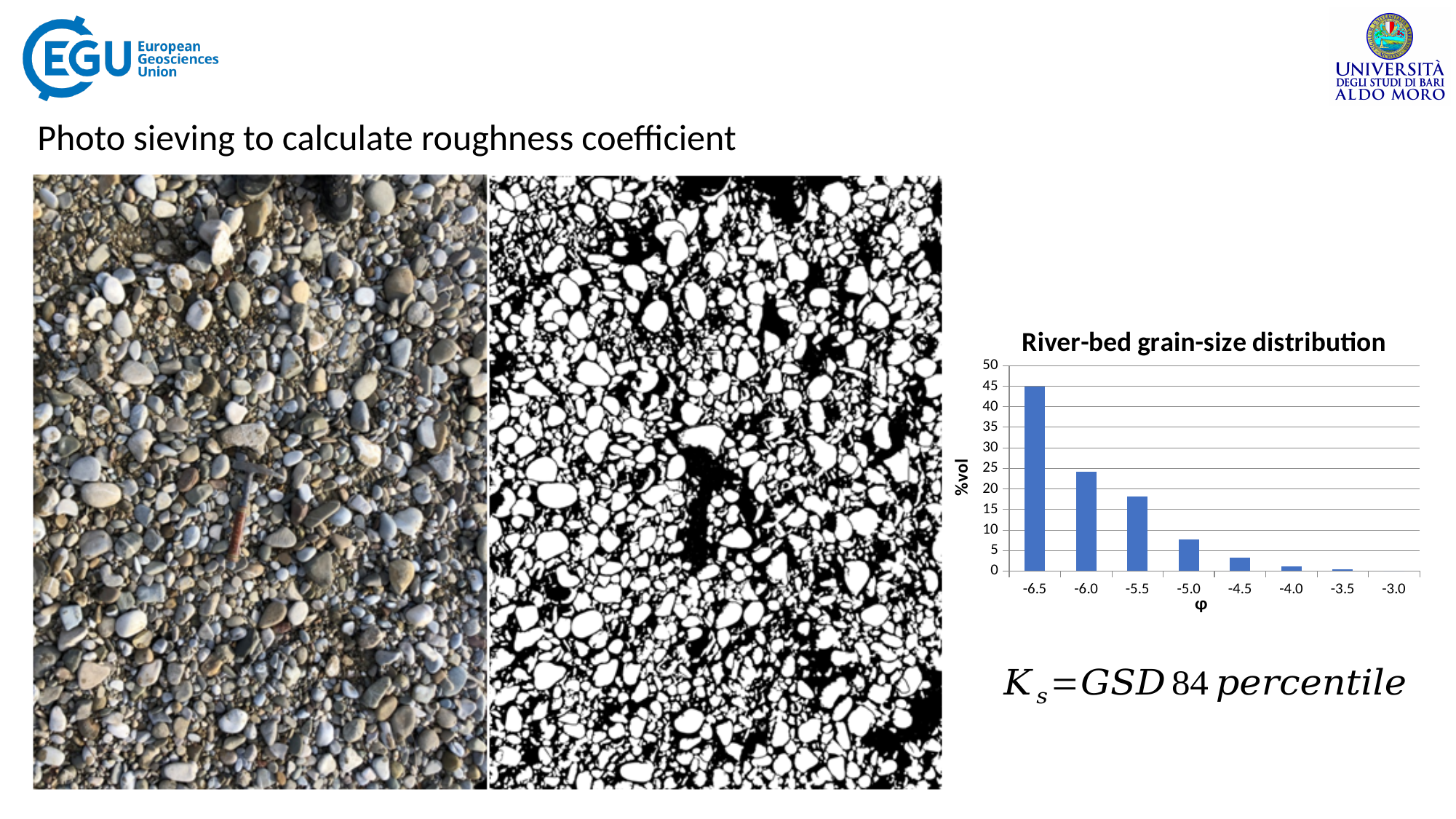
In the 'River-bed grain-size distribution' chart, is the %vol for φ = -5.0 greater or less than 10? less In the 'River-bed grain-size distribution' chart, which φ category has the highest %vol? -6.5 In the 'River-bed grain-size distribution' chart, which φ category has the lowest %vol? -3.0 In the 'River-bed grain-size distribution' chart, is the %vol for φ = -5.5 greater or less than 20? less In the 'River-bed grain-size distribution' chart, is the %vol for φ = -4.5 greater or less than 5? less What kind of chart is the 'River-bed grain-size distribution' chart? bar chart In the 'River-bed grain-size distribution' chart, which has a higher %vol, φ = -6.0 or φ = -5.5? -6.0 What is the label of the y axis of the 'River-bed grain-size distribution' chart? %vol In the 'River-bed grain-size distribution' chart, do the %vol values rise or fall as φ increases from -6.5 to -3.0? fall How many φ categories are shown on the x axis of the 'River-bed grain-size distribution' chart? 8